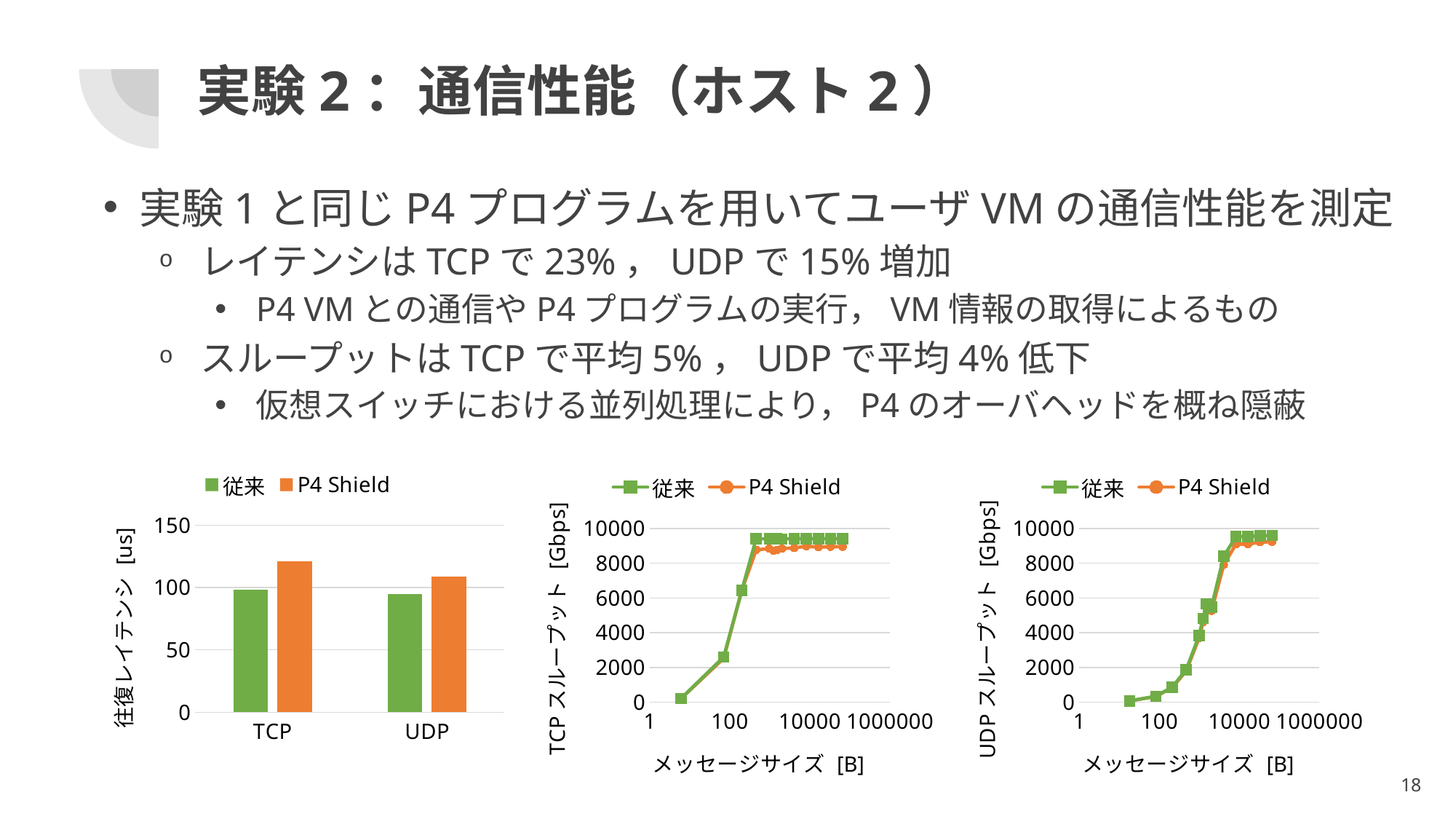
In the leftmost chart (往復レイテンシ), is the P4 Shield value for TCP greater or less than 100? greater How many categories are shown on the x axis of the leftmost chart (往復レイテンシ)? 2 In the rightmost chart (UDP スループット), is the 従来 value at the largest message size greater or less than 8000? greater What is the x-axis label of the rightmost chart (UDP スループット)? メッセージサイズ [B] What kind of chart is the middle chart (TCP スループット)? line chart What kind of chart is the leftmost chart (往復レイテンシ)? bar chart In the leftmost chart (往復レイテンシ), which series has the larger value for TCP, 従来 or P4 Shield? P4 Shield In the middle chart (TCP スループット), do the values rise or fall as message size increases along the x axis? rise How many series does the legend of the rightmost chart (UDP スループット) list? 2 In the leftmost chart (往復レイテンシ), is the 従来 value for UDP greater or less than 100? less How many series does the legend of the leftmost chart (往復レイテンシ) list? 2 In the leftmost chart (往復レイテンシ), which category has the higher P4 Shield bar, TCP or UDP? TCP